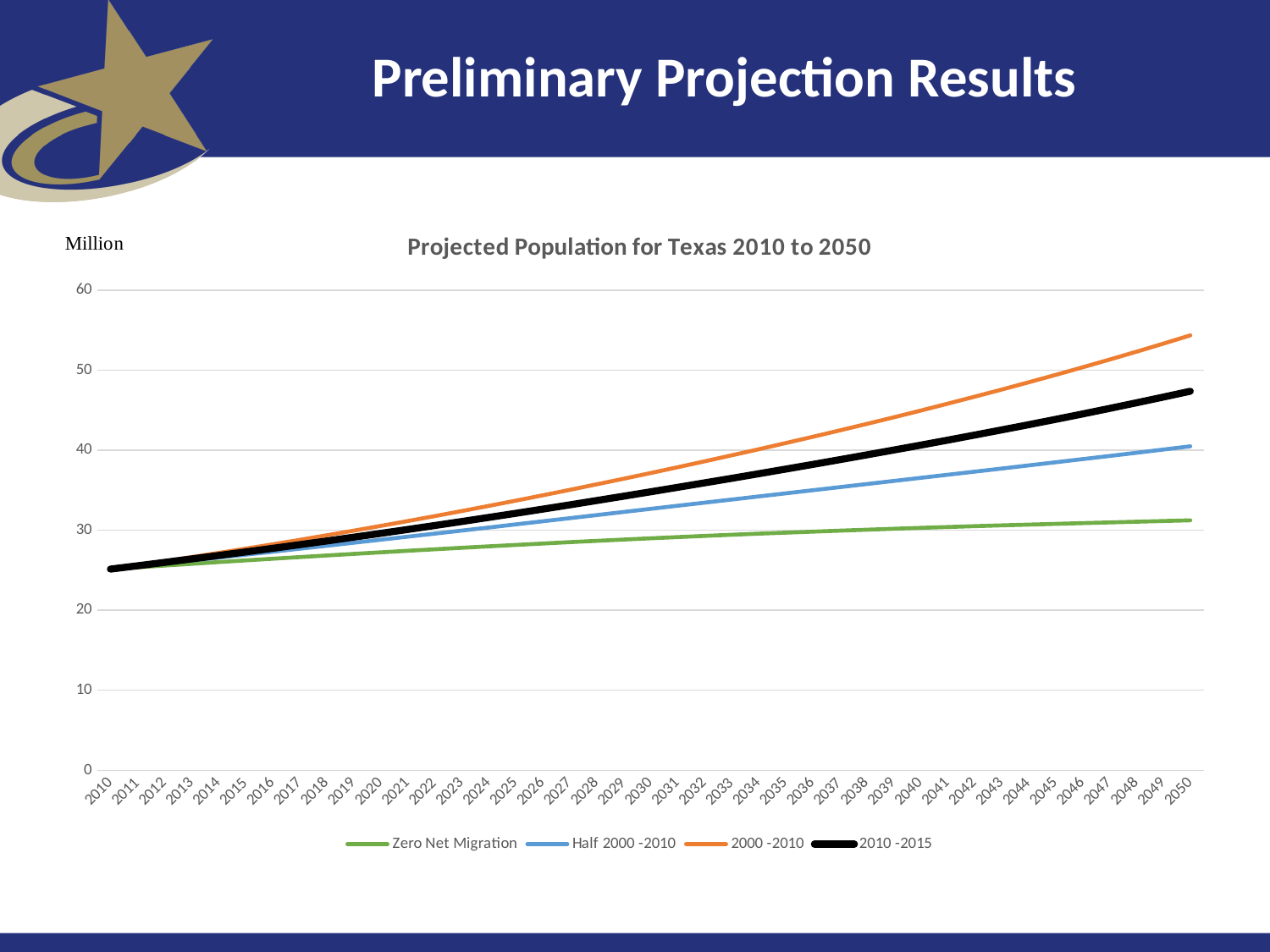
Which series has the highest value in 2050? 2000 -2010 What unit is shown for the vertical axis? Million Is the value for the 2010 -2015 series in 2050 greater or less than 50? less Do the values for the 2000 -2010 series rise or fall from 2010 to 2050? rise In 2050, which is larger: the 2010 -2015 series or the Half 2000 -2010 series? 2010 -2015 Is the value for the Zero Net Migration series in 2050 greater or less than 40? less How many series does the legend list? 4 Is the value for the 2000 -2010 series in 2050 greater or less than 50? greater How many years are shown along the x axis? 41 What kind of chart is shown on the slide? line chart What is the title of the chart? Projected Population for Texas 2010 to 2050 Which series has the lowest value in 2050? Zero Net Migration